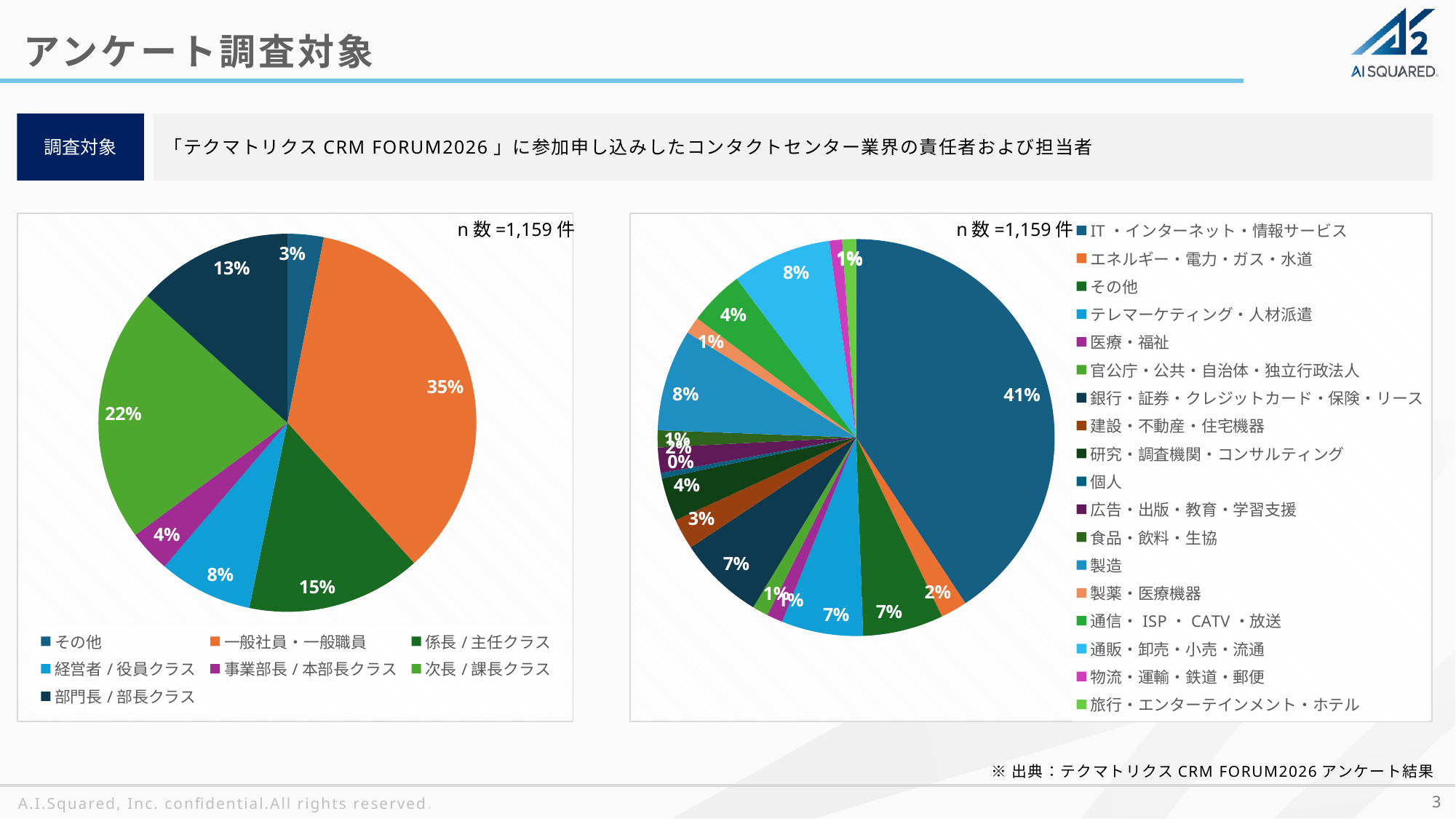
On the left pie chart, which category has the largest share? 一般社員・一般職員 On the left pie chart, which category has the smallest share? その他 How many categories does the legend of the left pie chart list? 7 On the right pie chart, which is larger: the share for 銀行・証券・クレジットカード・保険・リース or the share for 建設・不動産・住宅機器? 銀行・証券・クレジットカード・保険・リース On the right pie chart, what share is labelled for IT・インターネット・情報サービス? 41% On the left pie chart, what share is labelled for 次長 / 課長クラス? 22% What type of chart is shown on the left side of the slide? Pie chart On the right pie chart, what share is labelled for 製造? 8% On the left pie chart, what share is labelled for 一般社員・一般職員? 35% On the right pie chart, which category has the largest share? IT・インターネット・情報サービス How many categories does the legend of the right pie chart list? 18 On the left pie chart, what is the difference between the shares of 次長 / 課長クラス and 係長 / 主任クラス? 7%